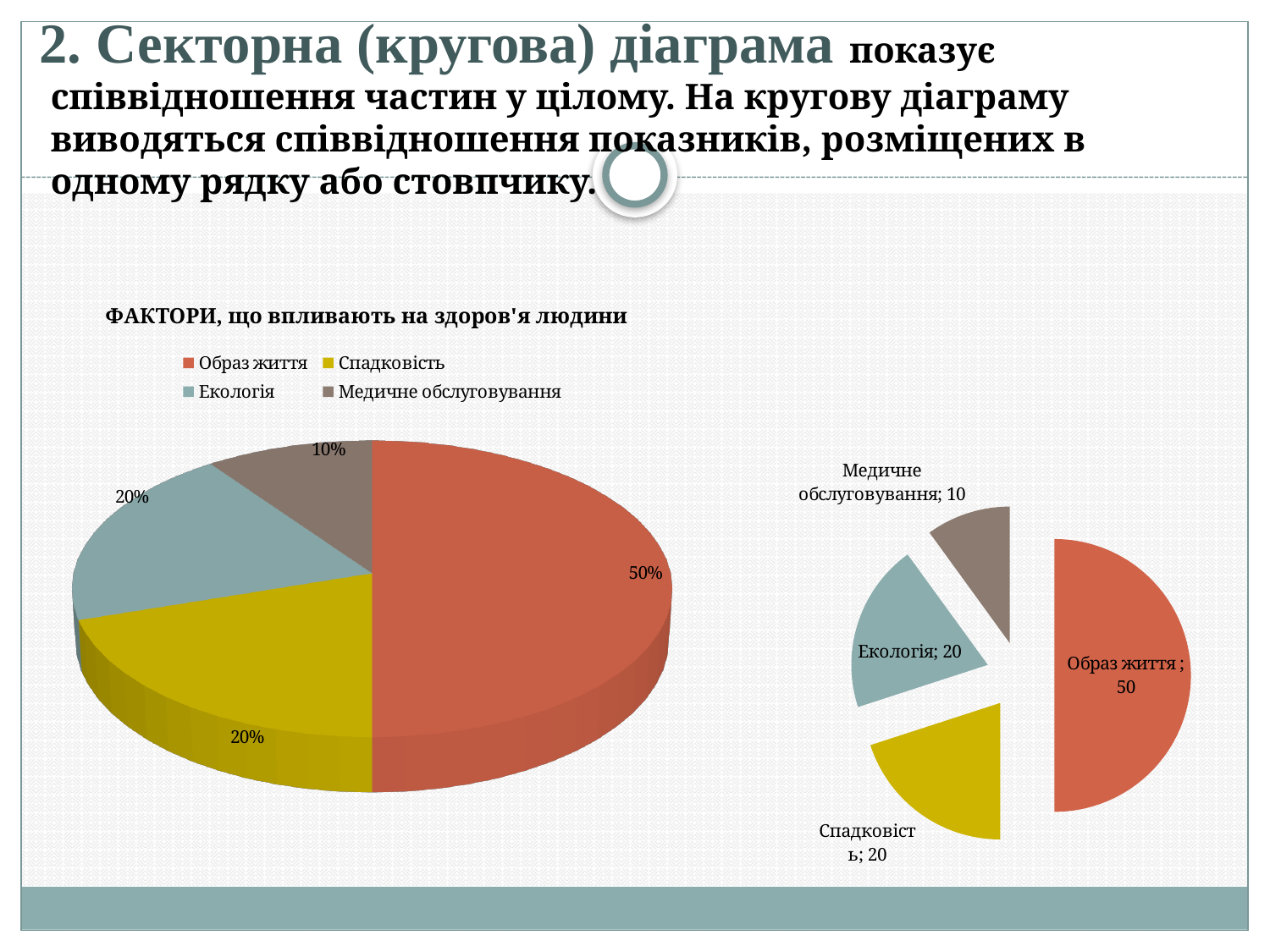
In the right pie chart, which category has the smallest slice? Медичне обслуговування In the right pie chart, what value is shown for 'Спадковість'? 20 In the right pie chart, what value is shown for 'Екологія'? 20 How many entries does the legend of the left pie chart list? 4 What type of chart is the left chart titled 'ФАКТОРИ, що впливають на здоров'я людини'? pie chart In the left pie chart, what percentage is shown for the 'Медичне обслуговування' slice? 10% What is the title of the left pie chart? ФАКТОРИ, що впливають на здоров'я людини In the right pie chart, which category has the largest slice? Образ життя In the right pie chart, what is the difference between the values for 'Образ життя' and 'Медичне обслуговування'? 40 In the left pie chart, what percentage is shown for the 'Образ життя' slice? 50% What type of chart is the right chart on the slide? pie chart In the right pie chart, which is larger: the value for 'Образ життя' or the value for 'Екологія'? Образ життя